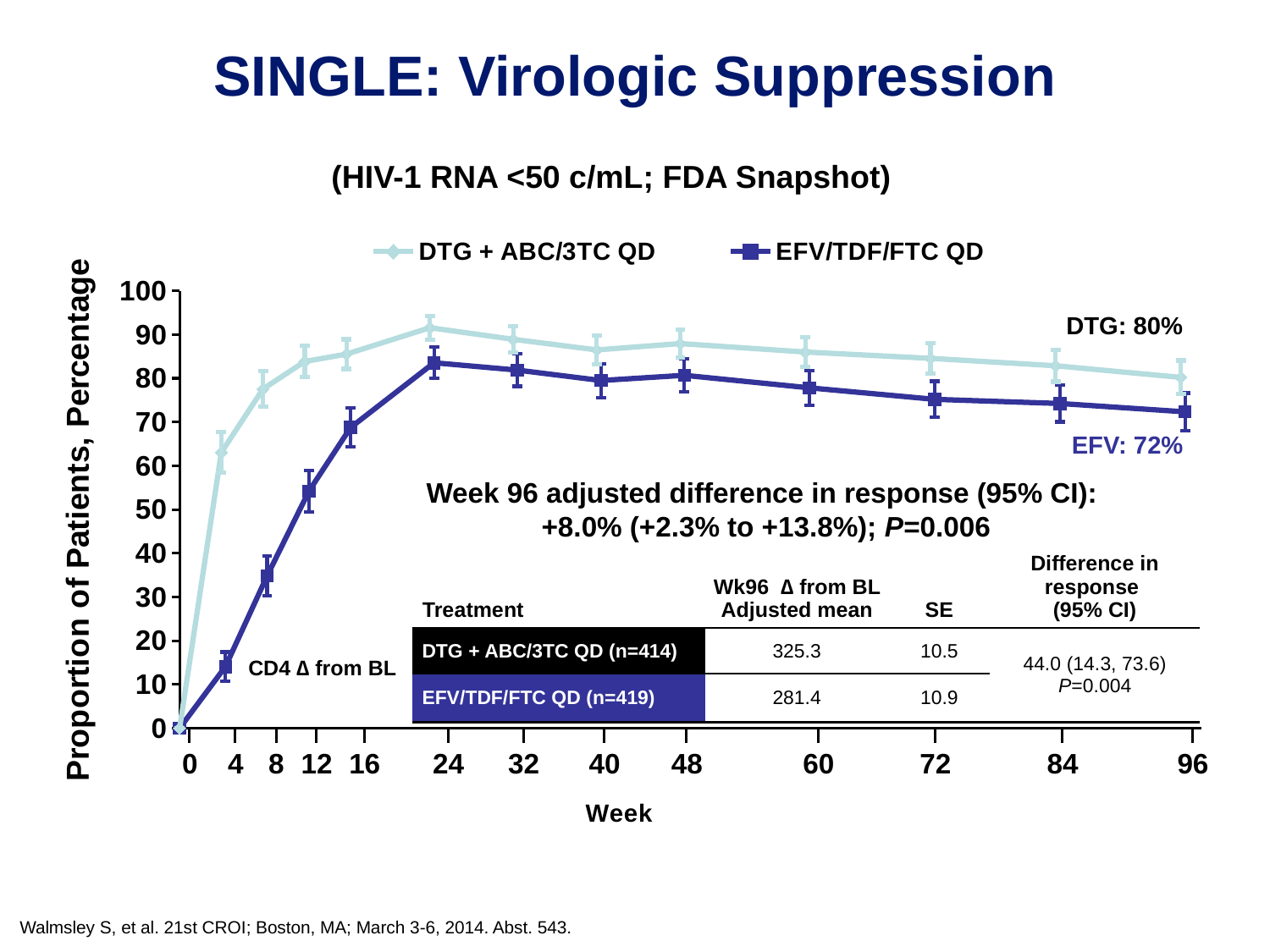
Is the value for DTG + ABC/3TC QD at week 4 greater or less than 50? greater What kind of chart is shown on the slide? Line chart Is the value for EFV/TDF/FTC QD at week 8 greater or less than 50? less How many week time points are marked on the x axis? 13 Which series has the higher value at week 96? DTG + ABC/3TC QD What is the difference between the DTG and EFV values labelled at week 96? 8 percentage points From week 24 to week 96, do the values for DTG + ABC/3TC QD rise or fall? fall What is the proportion of patients with HIV-1 RNA <50 c/mL at week 96 for DTG + ABC/3TC QD? 80% What is the proportion of patients with HIV-1 RNA <50 c/mL at week 96 for EFV/TDF/FTC QD? 72% Is the value for EFV/TDF/FTC QD at week 4 greater or less than 20? less How many series does the legend list? 2 What is the title of the y axis? Proportion of Patients, Percentage